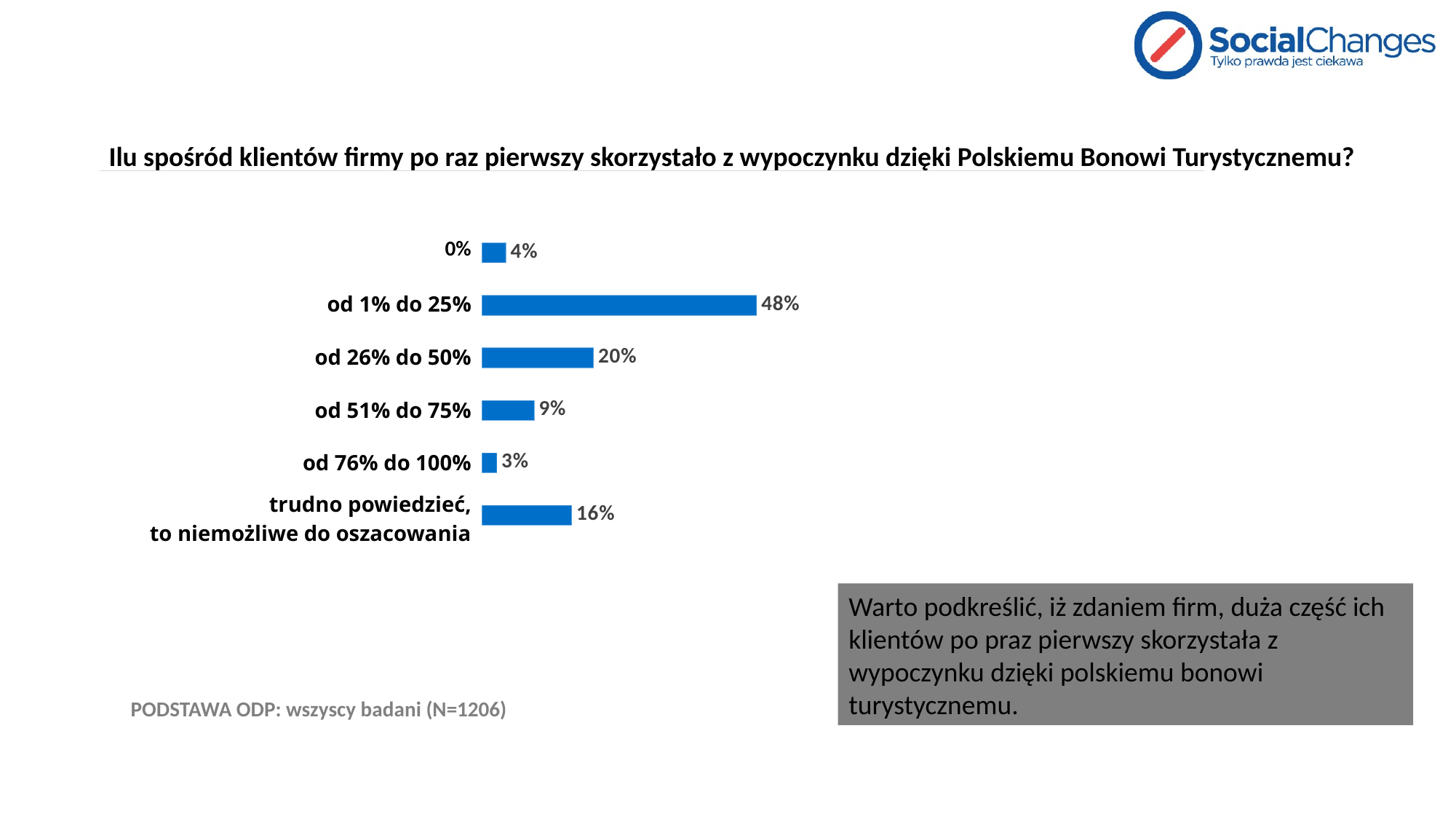
What is the base of respondents stated below the chart? wszyscy badani (N=1206) What is the value for the category "trudno powiedzieć, to niemożliwe do oszacowania"? 16% What is the difference between the values for "od 51% do 75%" and "od 76% do 100%"? 6% Which category has the highest value? od 1% do 25% What is the value for the category "0%"? 4% Which category has the lowest value? od 76% do 100% What is the value for the category "od 1% do 25%"? 48% What is the difference between the values for "od 1% do 25%" and "od 26% do 50%"? 28% What is the value for the category "od 26% do 50%"? 20% How many categories are shown in the chart? 6 What kind of chart is shown on the slide? bar chart Which is larger: the value for "od 51% do 75%" or the value for "trudno powiedzieć, to niemożliwe do oszacowania"? trudno powiedzieć, to niemożliwe do oszacowania